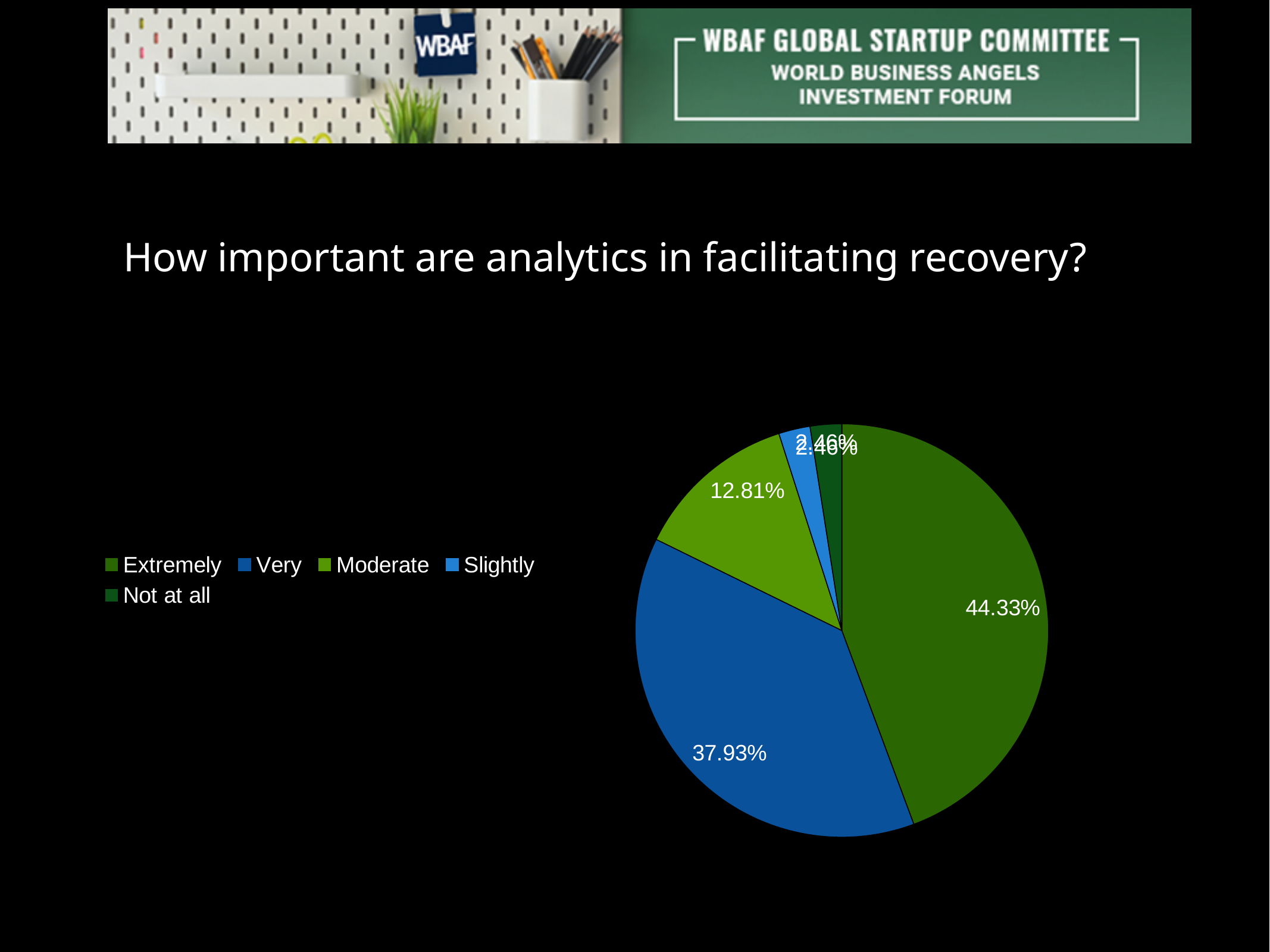
What is the value shown for the Very slice? 37.93% What is the difference between the Extremely and Very slices? 6.40% Which category has the largest slice of the pie? Extremely What share of the pie does the Extremely slice represent? 44.33% Which is larger, the Very slice or the Moderate slice? Very How many categories does the pie chart show? 5 What question does the slide title ask? How important are analytics in facilitating recovery? What is the difference between the Very and Moderate slices? 25.12% Which is larger, the Extremely slice or the Very slice? Extremely What kind of chart is shown on the slide? Pie chart What percentage is labelled on the Moderate slice? 12.81%